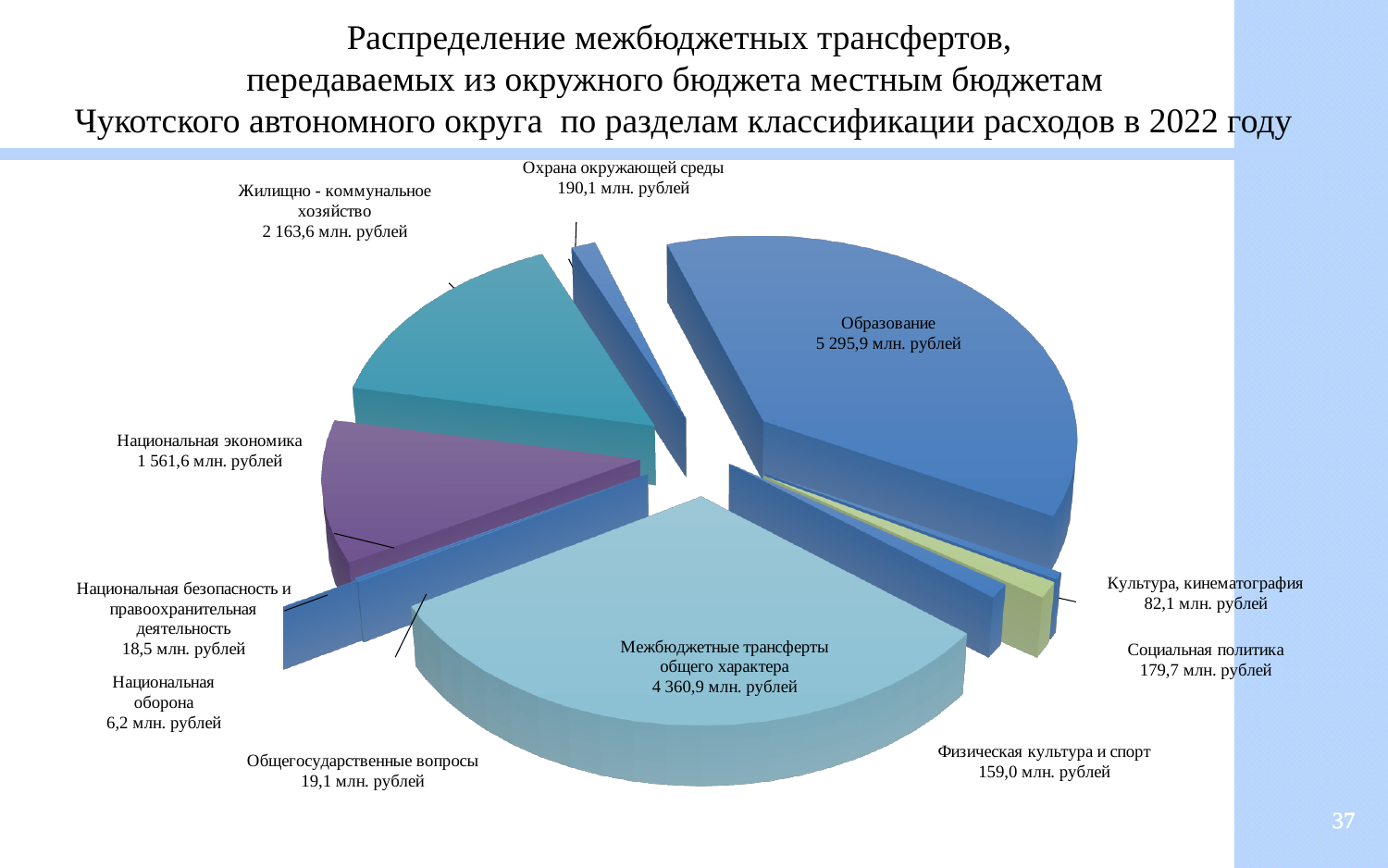
What is the value for Образование? 5 295,9 млн. рублей How many categories (slices) does the pie chart have? 11 What is the value for Межбюджетные трансферты общего характера? 4 360,9 млн. рублей What is the value for Культура, кинематография? 82,1 млн. рублей What is the value for Национальная экономика? 1 561,6 млн. рублей Which category has the largest value? Образование What is the difference between Охрана окружающей среды and Социальная политика? 10,4 млн. рублей Which is larger: Социальная политика or Физическая культура и спорт? Социальная политика What is the difference between Образование and Межбюджетные трансферты общего характера? 935,0 млн. рублей Which is larger: Жилищно-коммунальное хозяйство or Национальная экономика? Жилищно-коммунальное хозяйство What kind of chart is shown on the slide? Pie chart Which category has the smallest value? Национальная оборона